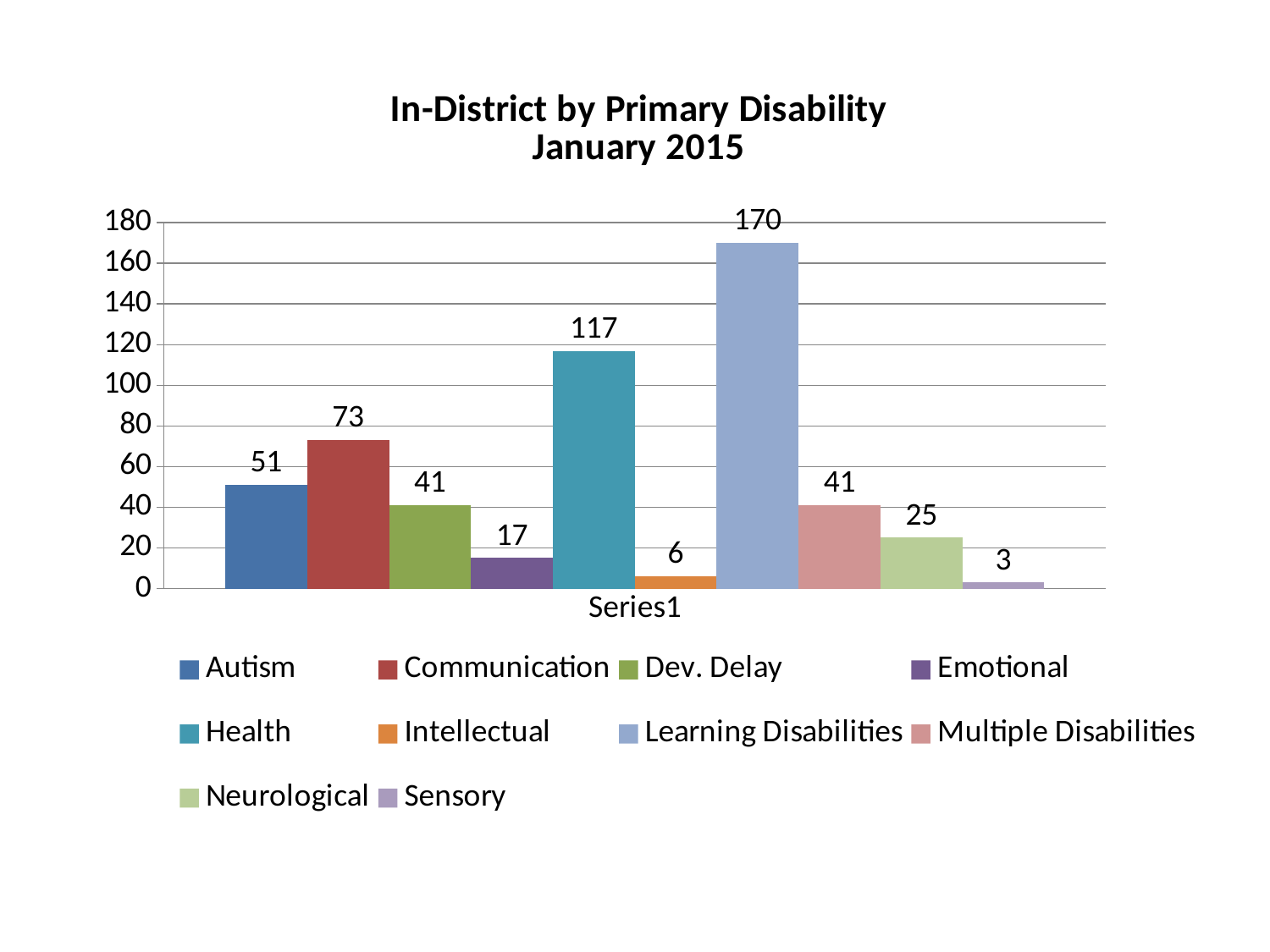
What is the difference between the values for Communication and Autism? 22 Which disability category has the lowest value? Sensory What is the value for Learning Disabilities? 170 Which disability category has the highest value? Learning Disabilities What is the title of the chart? In-District by Primary Disability January 2015 Is the value for Health greater or less than 100? greater What is the value for Health? 117 What is the difference between the values for Learning Disabilities and Health? 53 How many disability categories does the legend list? 10 What is the value for Emotional? 17 Which is larger, the value for Neurological or the value for Intellectual? Neurological What kind of chart is shown on the slide? bar chart